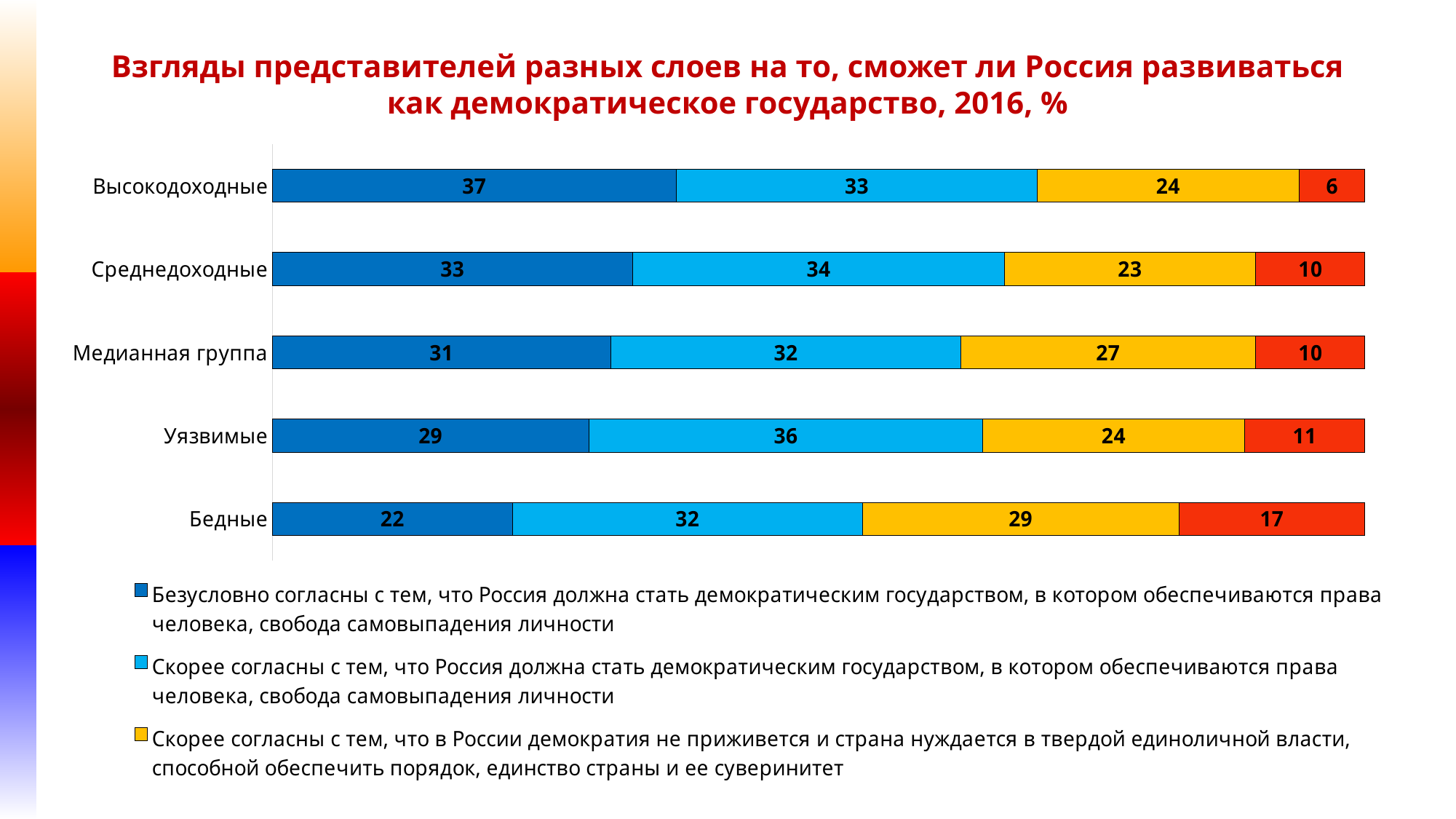
Which category has the highest value for the dark blue series ("Безусловно согласны...")? Высокодоходные What kind of chart is shown on the slide? Stacked bar chart How many categories (income groups) are shown on the chart? 5 Which category has the lowest value for the dark blue series ("Безусловно согласны...")? Бедные How many entries does the legend list? 3 What is the difference between the dark blue values for Высокодоходные and Бедные? 15 What is the total of the stacked bar for Бедные? 100 What is the value of the yellow segment ("Скорее согласны с тем, что в России демократия не приживется...") for Бедные? 29 Which category has the largest rightmost red segment? Бедные What is the value of the dark blue segment ("Безусловно согласны...") for Высокодоходные? 37 What is the value of the rightmost red segment for Высокодоходные? 6 Which is larger: the light blue value for Уязвимые or for Среднедоходные? Уязвимые